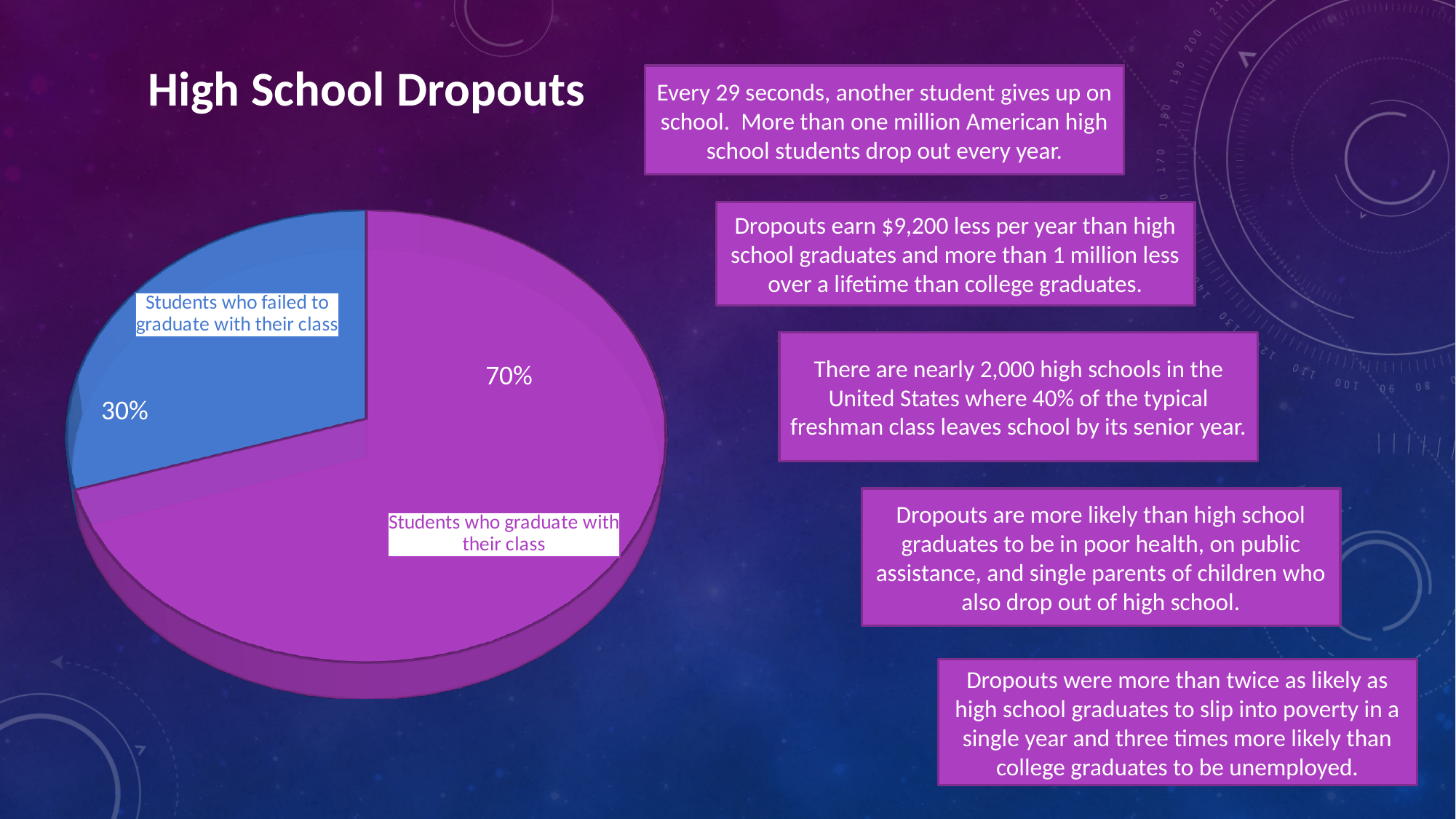
What is the difference in percentage points between the 'Students who graduate with their class' slice and the 'Students who failed to graduate with their class' slice? 40 What colour is the slice for 'Students who graduate with their class'? Purple What percentage of the pie is labelled 'Students who failed to graduate with their class'? 30% What kind of chart is shown on the slide? Pie chart What share of the pie does the 'Students who failed to graduate with their class' slice represent? 30% What percentage of the pie is labelled 'Students who graduate with their class'? 70% Which slice of the pie chart is the smallest? Students who failed to graduate with their class Which is larger: the share of students who graduate with their class or the share who failed to graduate with their class? Students who graduate with their class Which slice of the pie chart is the largest? Students who graduate with their class How many slices does the pie chart have? 2 What colour is the slice for 'Students who failed to graduate with their class'? Blue